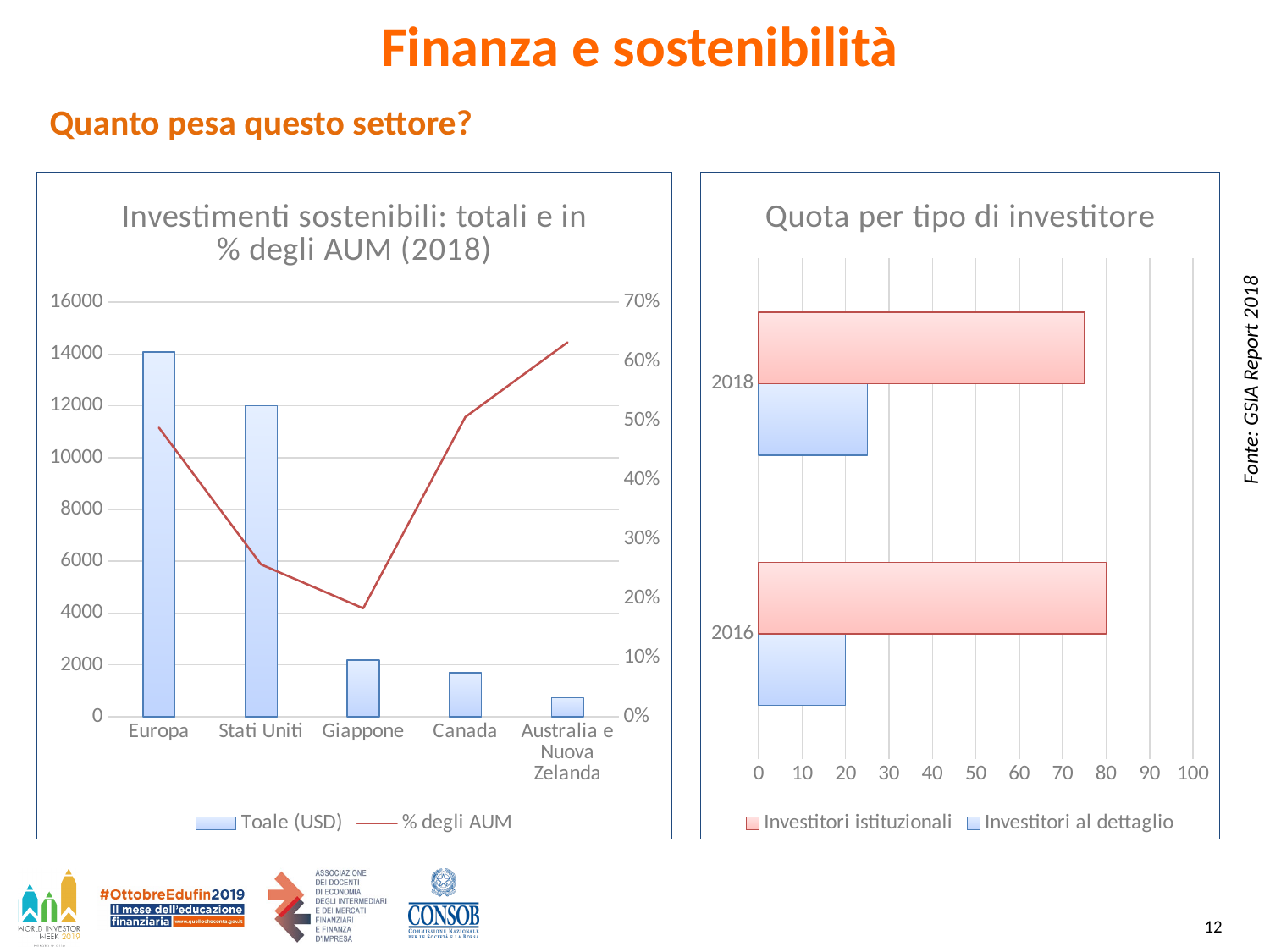
In the chart titled 'Quota per tipo di investitore', is the value for 'Investitori al dettaglio' in 2018 greater or less than 30? less In the chart titled 'Investimenti sostenibili: totali e in % degli AUM (2018)', how many series does the legend list? 2 In the chart titled 'Quota per tipo di investitore', is the value for 'Investitori istituzionali' in 2016 greater or less than 70? greater In the chart titled 'Investimenti sostenibili: totali e in % degli AUM (2018)', which category has the highest '% degli AUM' value? Australia e Nuova Zelanda What kind of chart is the chart titled 'Quota per tipo di investitore'? bar chart In the chart titled 'Investimenti sostenibili: totali e in % degli AUM (2018)', how many categories are shown on the x axis? 5 In the chart titled 'Investimenti sostenibili: totali e in % degli AUM (2018)', which category has the lowest 'Toale (USD)' bar? Australia e Nuova Zelanda In the chart titled 'Investimenti sostenibili: totali e in % degli AUM (2018)', which category has the highest 'Toale (USD)' bar? Europa In the chart titled 'Quota per tipo di investitore', which is larger in 2018: 'Investitori istituzionali' or 'Investitori al dettaglio'? Investitori istituzionali In the chart titled 'Investimenti sostenibili: totali e in % degli AUM (2018)', is the 'Toale (USD)' value for Europa greater or less than 12000? greater In the chart titled 'Investimenti sostenibili: totali e in % degli AUM (2018)', which category has the lowest '% degli AUM' value? Giappone